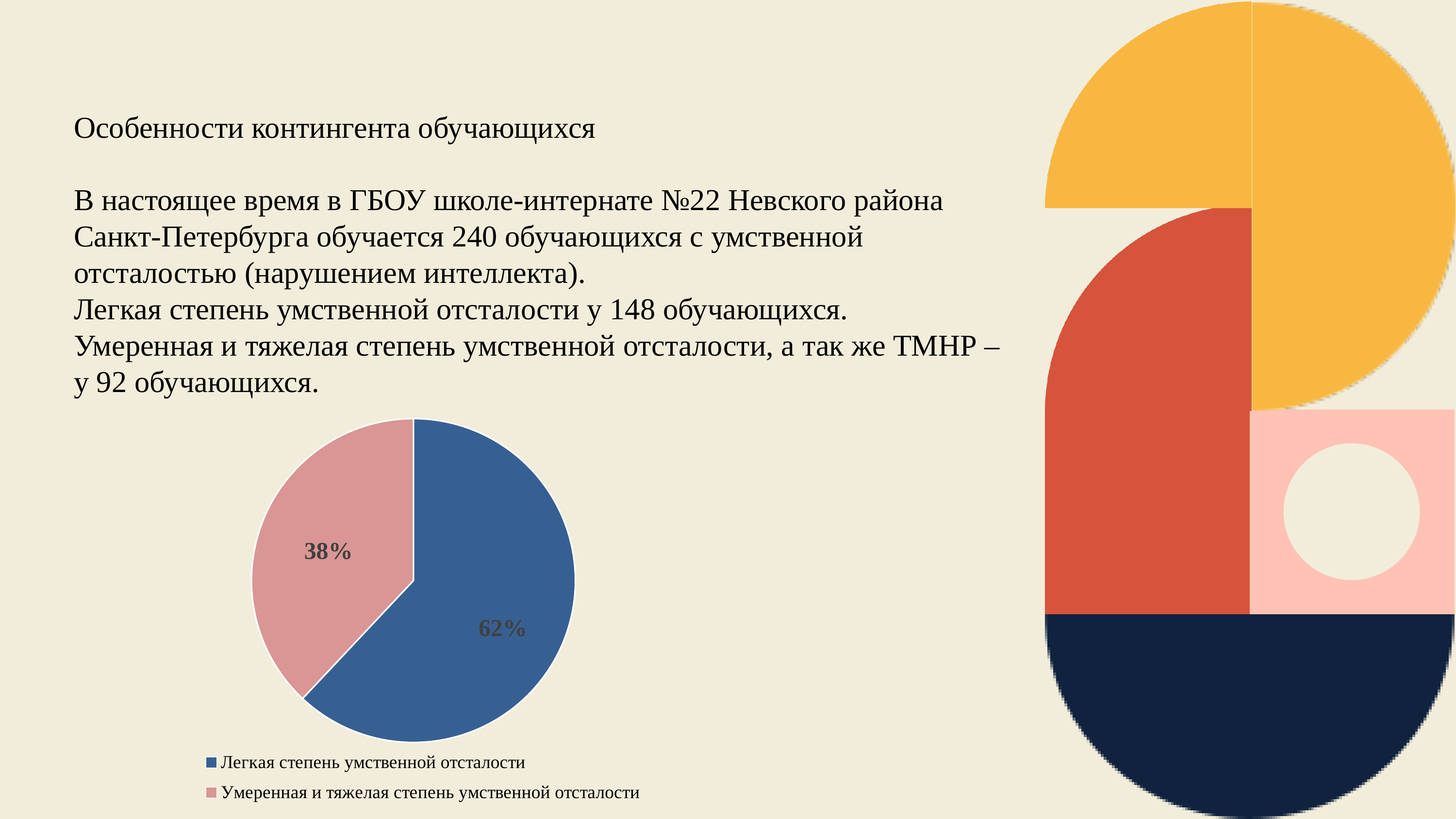
Which category has the smallest slice of the pie? Умеренная и тяжелая степень умственной отсталости What is the value shown on the blue slice of the pie? 62% What share of the pie does "Легкая степень умственной отсталости" have? 62% How many slices does the pie chart have? 2 What share of the pie does "Умеренная и тяжелая степень умственной отсталости" have? 38% How many entries does the legend list? 2 Which category has the largest slice of the pie? Легкая степень умственной отсталости What colour is the slice for "Умеренная и тяжелая степень умственной отсталости"? pink Which slice is larger: "Легкая степень умственной отсталости" or "Умеренная и тяжелая степень умственной отсталости"? Легкая степень умственной отсталости What colour is the slice for "Легкая степень умственной отсталости"? blue What is the difference in percentage points between the two slices of the pie? 24 What kind of chart is shown on the slide? pie chart